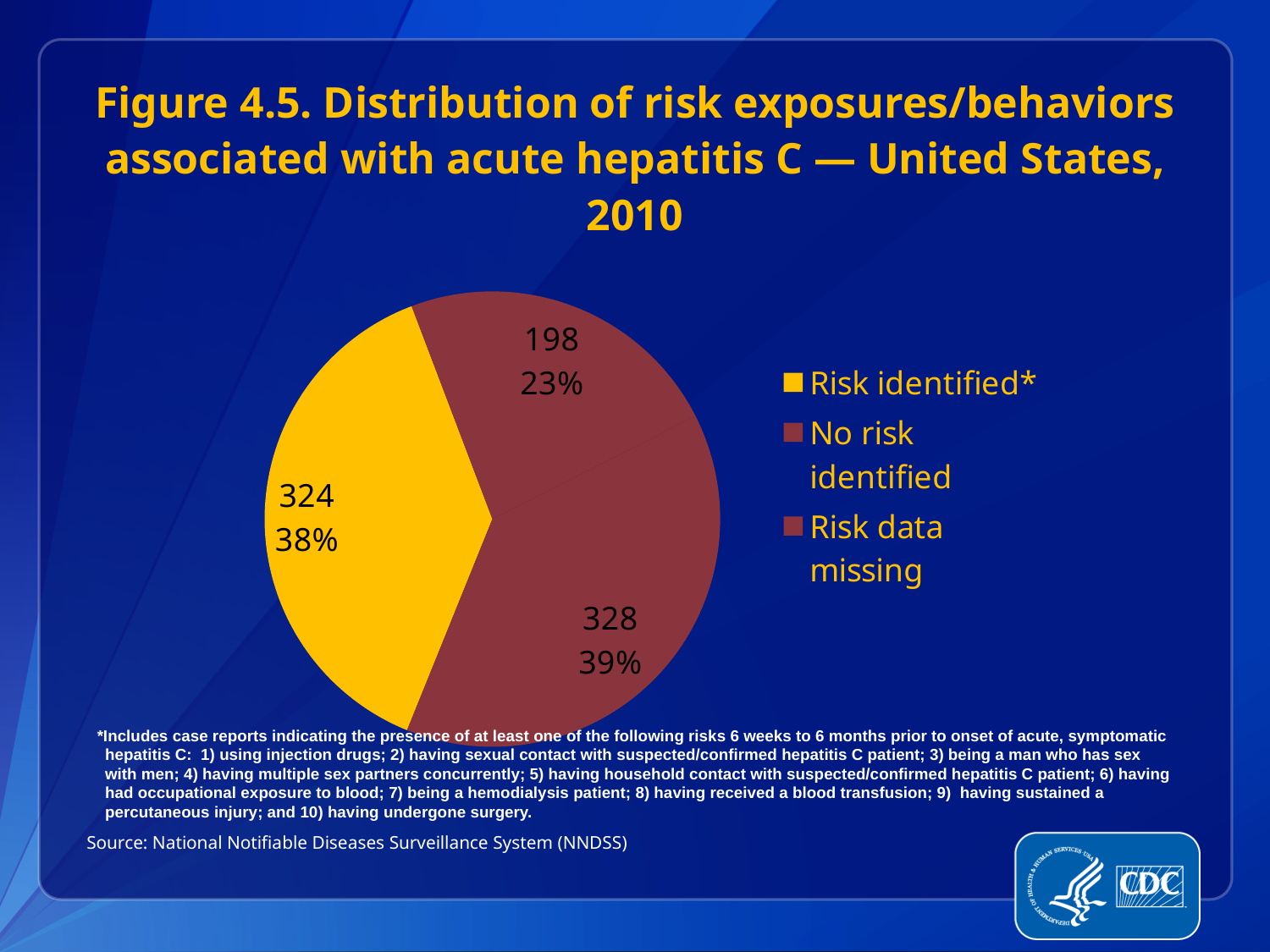
What is the number of cases for the 'Risk identified*' slice? 324 What is the smallest value shown on the pie chart? 198 What is the largest value shown on the pie chart? 328 What type of chart is shown on the slide? pie chart What colour is the 'Risk identified*' slice? yellow How many slices does the pie chart have? 3 What year does the chart title say the data is for? 2010 What percentage of the pie does the 'Risk identified*' slice represent? 38% What percentage is shown for the smallest slice of the pie? 23% How many entries does the legend list? 3 What is the difference between the 'Risk identified*' value and the smallest slice value (198)? 126 What is the difference between the largest slice value (328) and the 'Risk identified*' value? 4